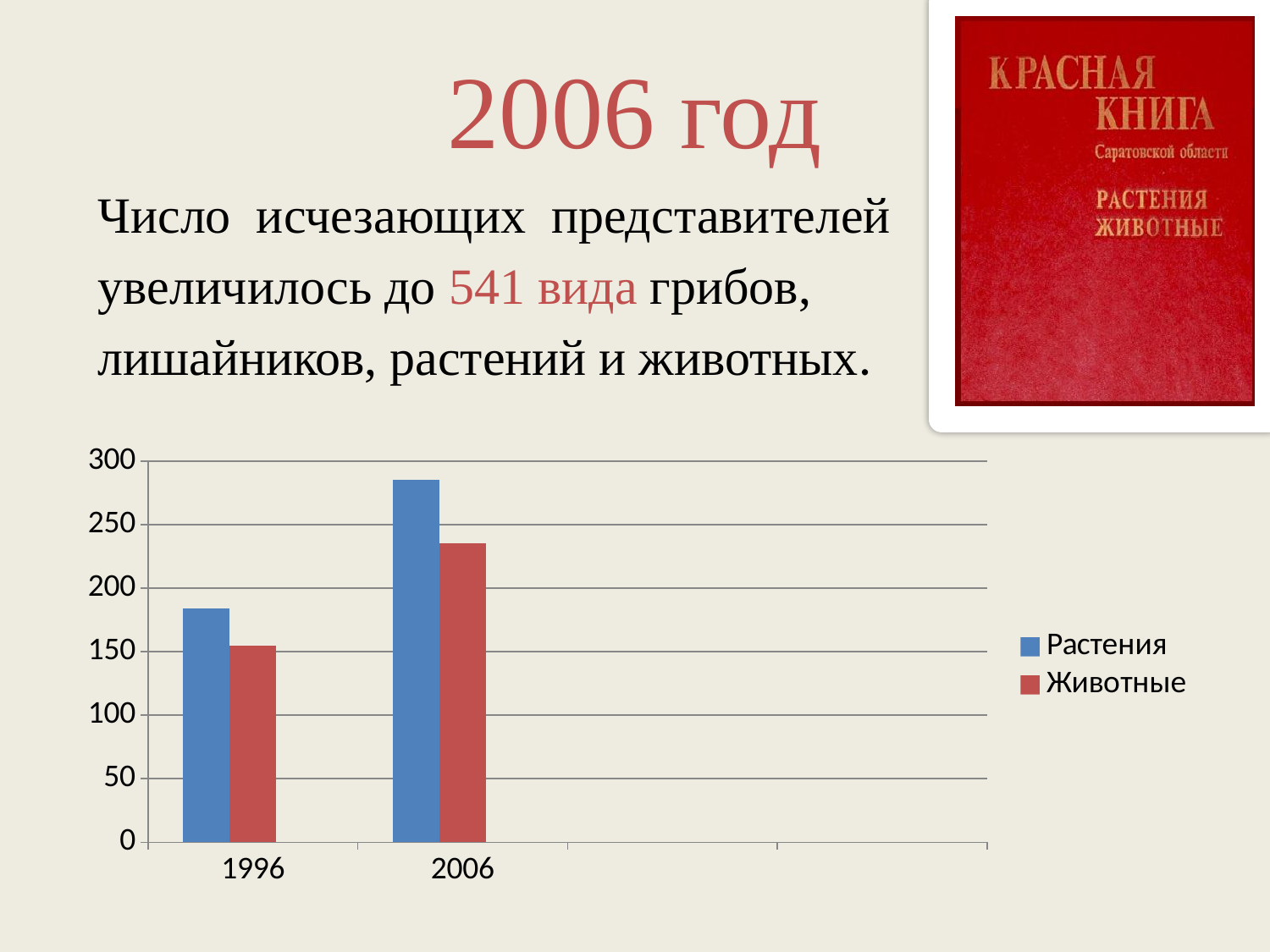
How many year categories are shown on the x axis of the chart? 2 In 2006, which series has the larger value, Растения or Животные? Растения Is the value for Растения in 1996 greater or less than 150? greater Is the value for Растения in 2006 greater or less than 250? greater Is the value for Животные in 2006 greater or less than 250? less How many series does the chart legend list? 2 Which series is shown in red in the chart legend? Животные What kind of chart is shown on the slide? bar chart Does the value for Растения rise or fall from 1996 to 2006? rise Which series is shown in blue in the chart legend? Растения